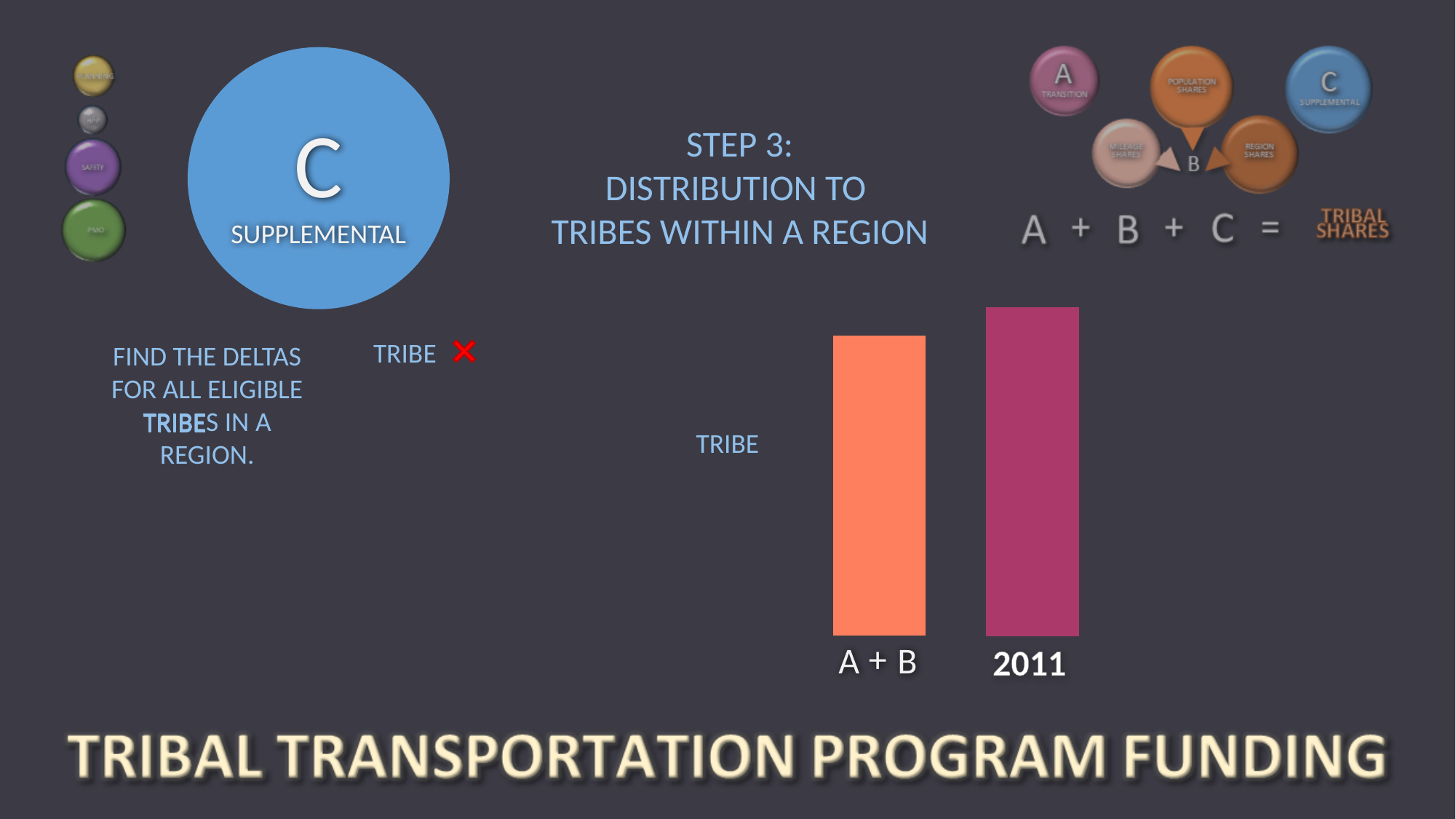
What kind of chart is shown on the slide? bar chart How many bars does the chart show? 2 Which category has the lowest bar in the chart? A + B What are the labels of the two bars in the chart? A + B and 2011 Which bar is taller, A + B or 2011? 2011 Which category has the highest bar in the chart? 2011 What colour is the A + B bar? orange